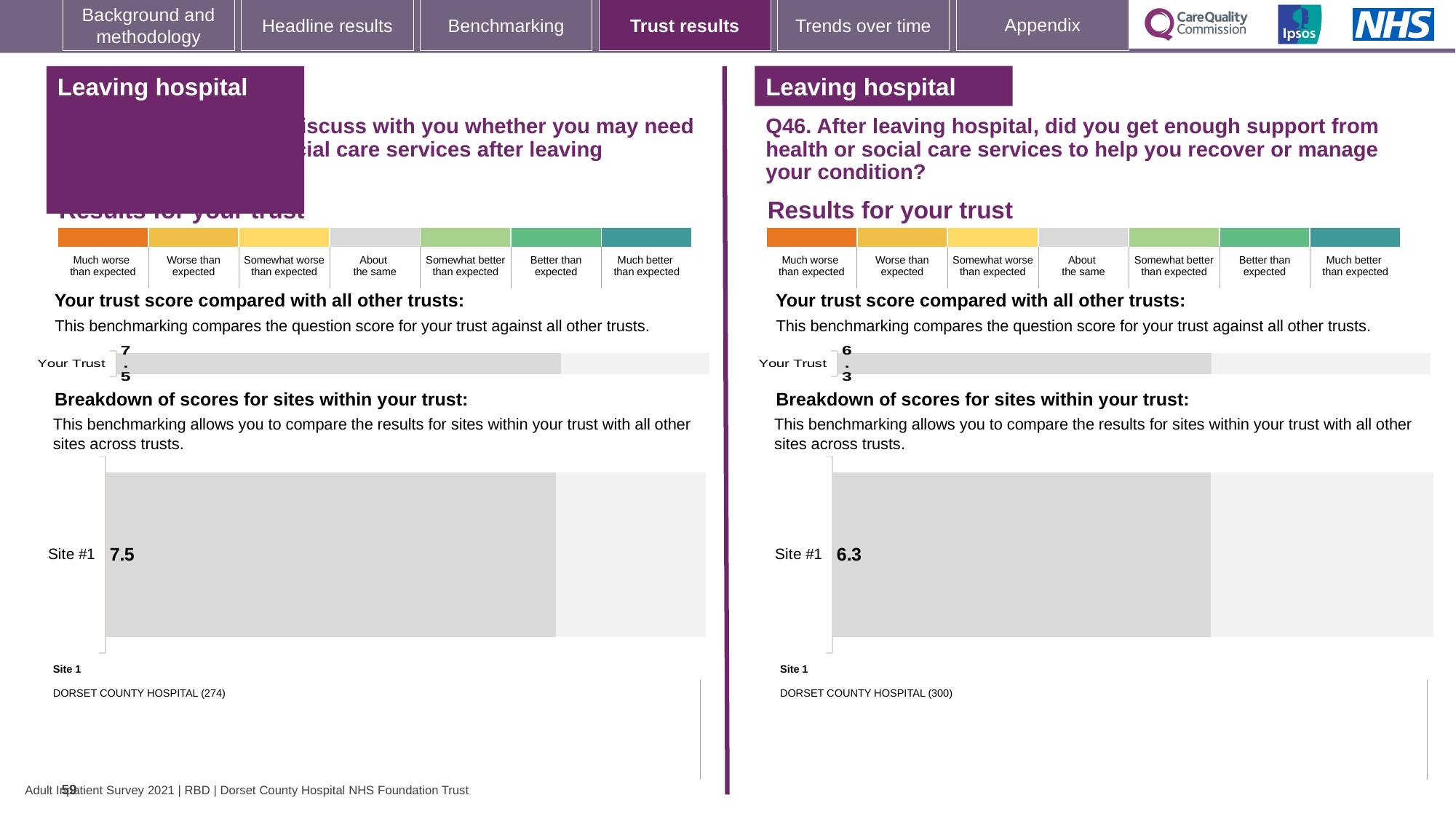
How many sites are shown in the breakdown of scores on the left-hand chart? 1 On the right-hand chart for Q46, what is the score shown for Your Trust? 6.3 On the left-hand chart, what is the score shown for Your Trust? 7.5 On the left-hand chart, which site is listed as Site 1? DORSET COUNTY HOSPITAL (274) On the right-hand chart for Q46, what is the score shown for Site #1? 6.3 What is the difference between the Site #1 score on the left-hand chart and the Site #1 score on the right-hand chart for Q46? 1.2 On the right-hand chart for Q46, is the Site #1 score greater or less than the Your Trust score, or are they equal? Equal On the right-hand chart for Q46, which site is listed as Site 1? DORSET COUNTY HOSPITAL (300) On the left-hand chart, what is the score shown for Site #1? 7.5 What kind of chart is used to show the breakdown of scores for sites within your trust on the right-hand side? Bar chart Which is larger: the Site #1 score on the left-hand chart or the Site #1 score on the right-hand chart for Q46? Left-hand chart (7.5)